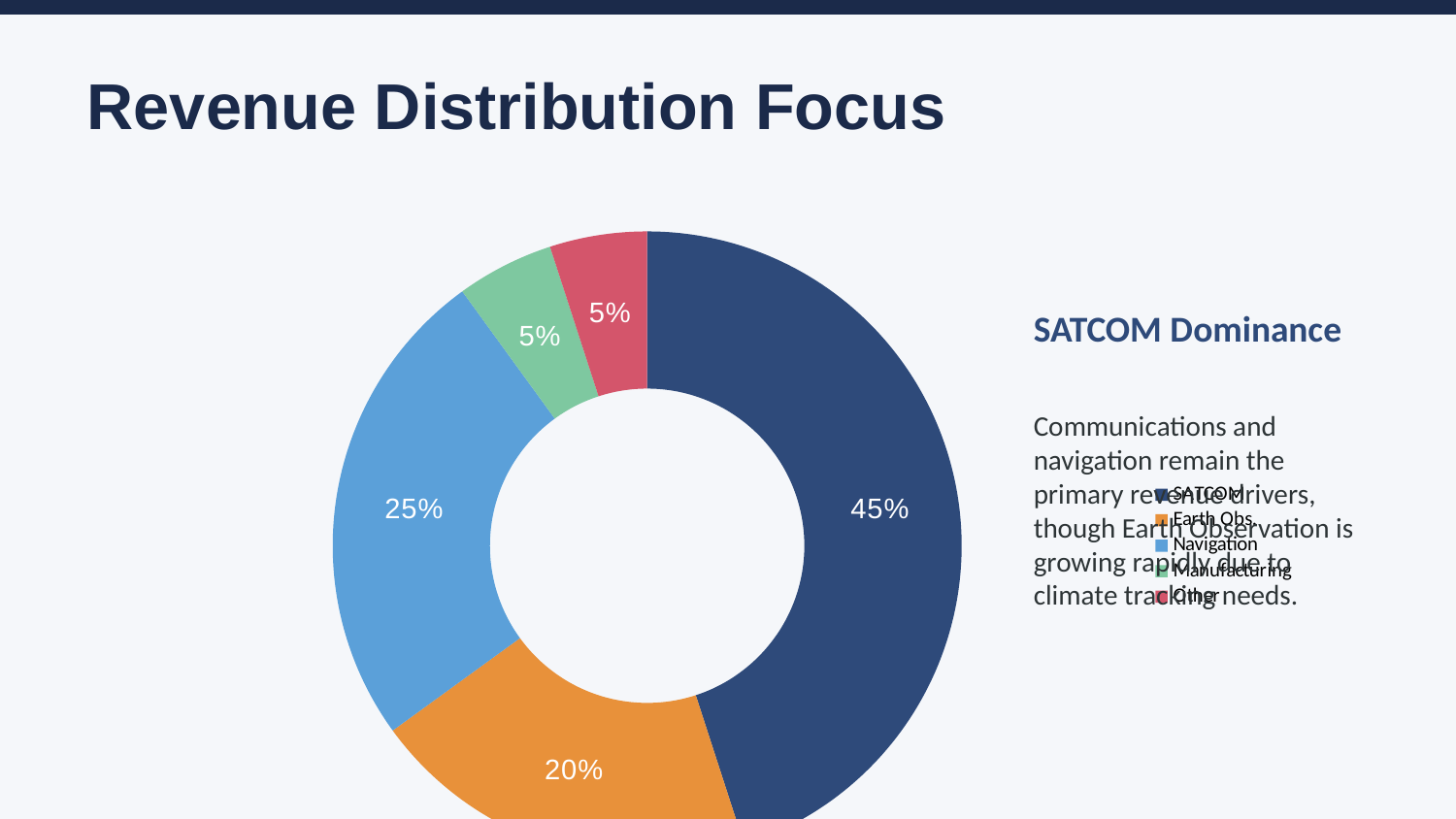
What kind of chart is shown on the slide? Pie chart (donut) What is the title of the slide containing the chart? Revenue Distribution Focus What is the difference in percentage points between the SATCOM slice and the Navigation slice? 20 Which slice is larger, Navigation or Earth Obs.? Navigation What percentage is shown for the Navigation slice? 25% What percentage is shown for the Manufacturing slice? 5% Which category has the largest slice of the donut chart? SATCOM How many entries does the chart legend list? 5 What percentage is shown for the Earth Obs. slice? 20% How many slices does the donut chart have? 5 What share of revenue does the SATCOM slice represent? 45% What colour is the SATCOM slice in the chart? Dark blue